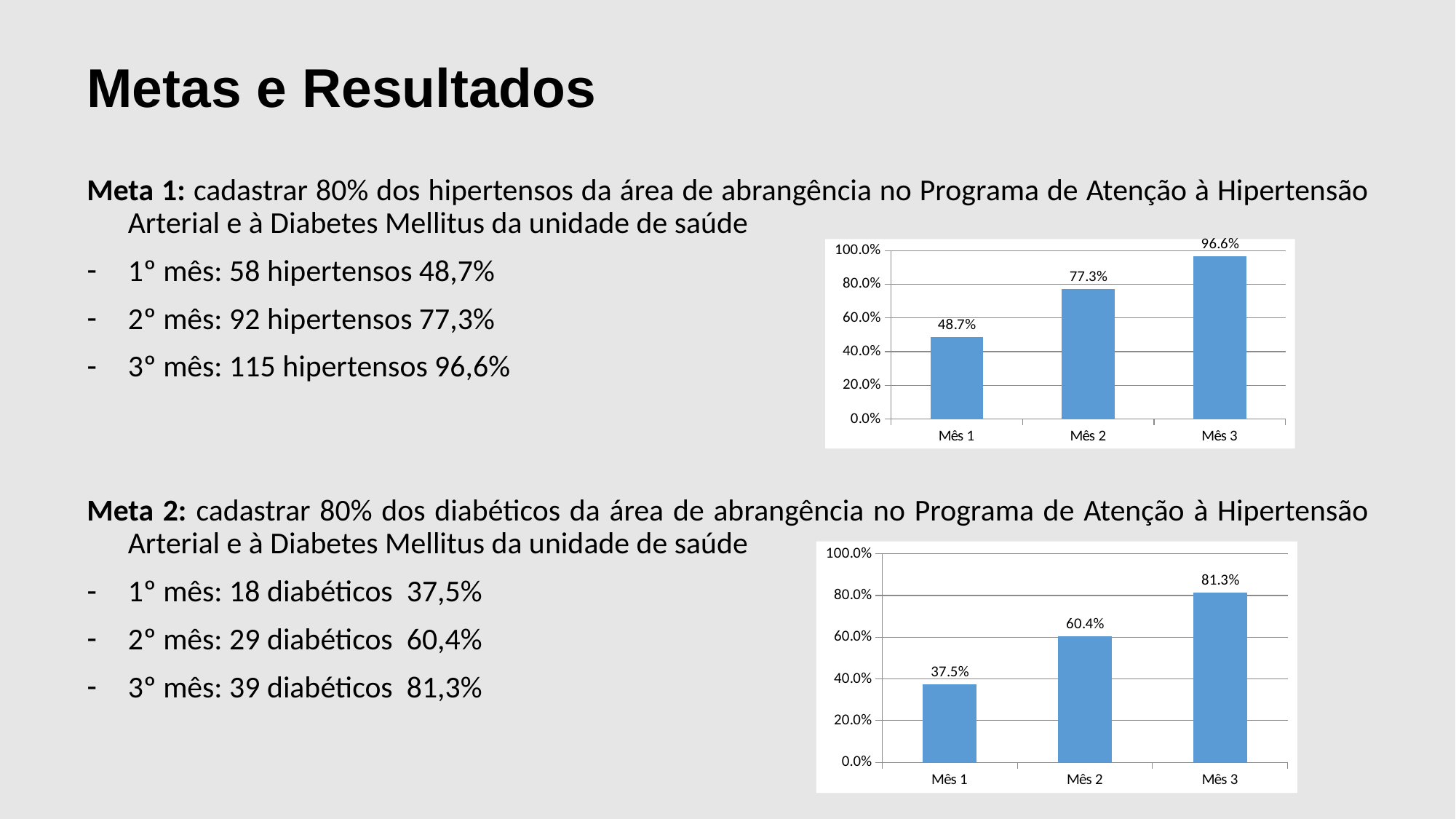
In the upper chart (next to Meta 1), is the value for Mês 1 greater or less than 60.0%? less In the lower chart (next to Meta 2), what is the value for Mês 1? 37.5% What type of chart is the lower chart (next to Meta 2)? bar chart Which is larger: Mês 3 in the upper chart or Mês 3 in the lower chart? Mês 3 in the upper chart In the lower chart (next to Meta 2), is the value for Mês 3 greater or less than 80.0%? greater In the upper chart (next to Meta 1), what is the difference between Mês 3 and Mês 1? 47.9% In the upper chart (next to Meta 1), how many bars are plotted? 3 In the lower chart (next to Meta 2), which month has the lowest value? Mês 1 In the upper chart (next to Meta 1), which month has the highest value? Mês 3 In the upper chart (next to Meta 1), do the values rise or fall from Mês 1 to Mês 3? rise In the lower chart (next to Meta 2), what is the difference between Mês 3 and Mês 2? 20.9% In the upper chart (next to Meta 1), what is the value for Mês 2? 77.3%